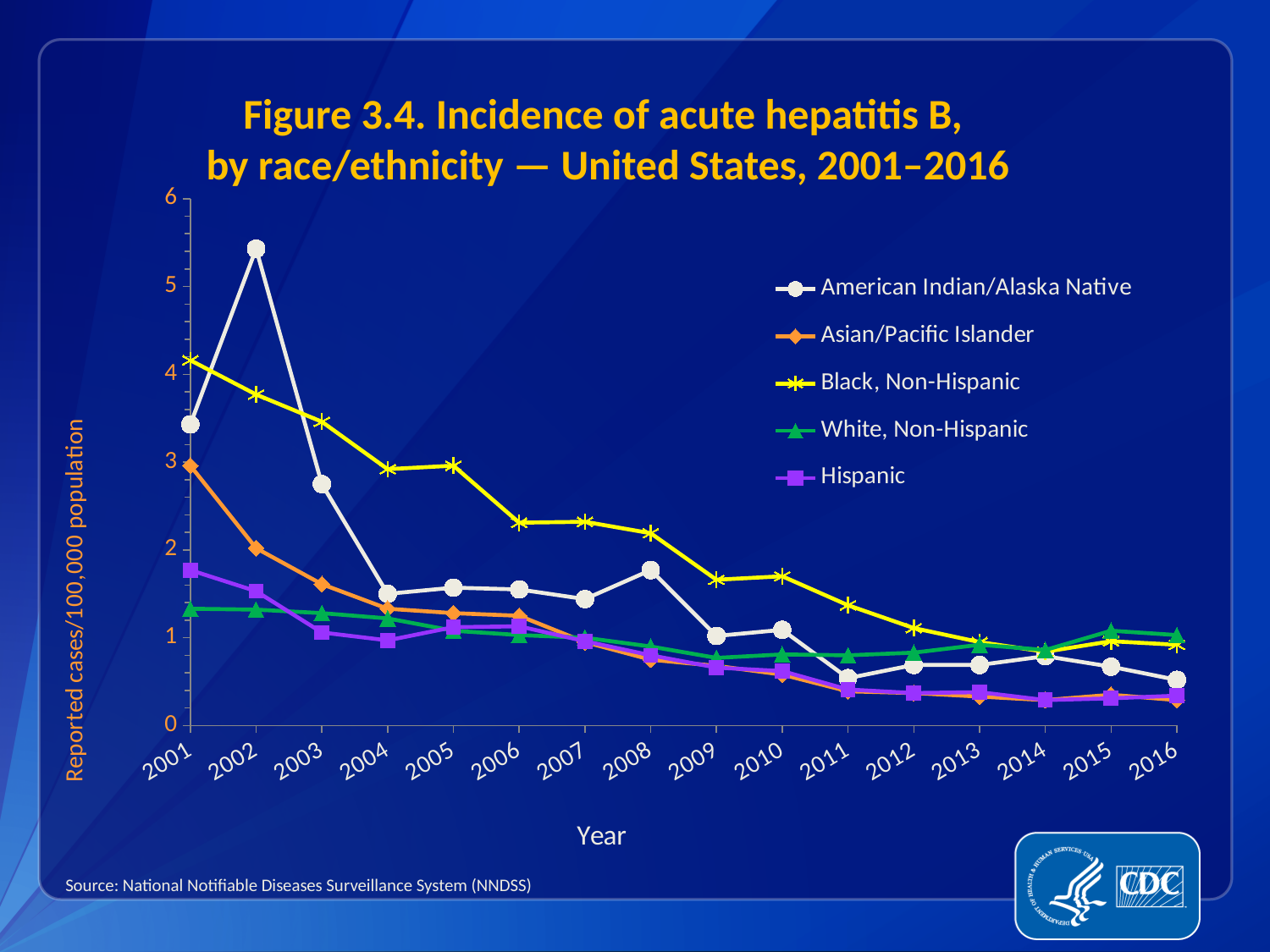
Is the value for American Indian/Alaska Native in 2002 greater or less than 5? greater Does the incidence for Black, Non-Hispanic rise or fall from 2001 to 2016? fall How many years are shown along the x axis? 16 Is the value for Black, Non-Hispanic in 2001 greater or less than 3? greater In 2001, which is larger: the value for Asian/Pacific Islander or the value for Hispanic? Asian/Pacific Islander Which race/ethnicity group has the highest incidence in 2008? Black, Non-Hispanic Is the value for Hispanic in 2016 greater or less than 1? less What is the label of the y axis? Reported cases/100,000 population Which race/ethnicity group has the lowest incidence in 2001? White, Non-Hispanic How many series does the legend list? 5 What kind of chart is shown on the slide? Line chart Which race/ethnicity group has the highest incidence in 2002? American Indian/Alaska Native